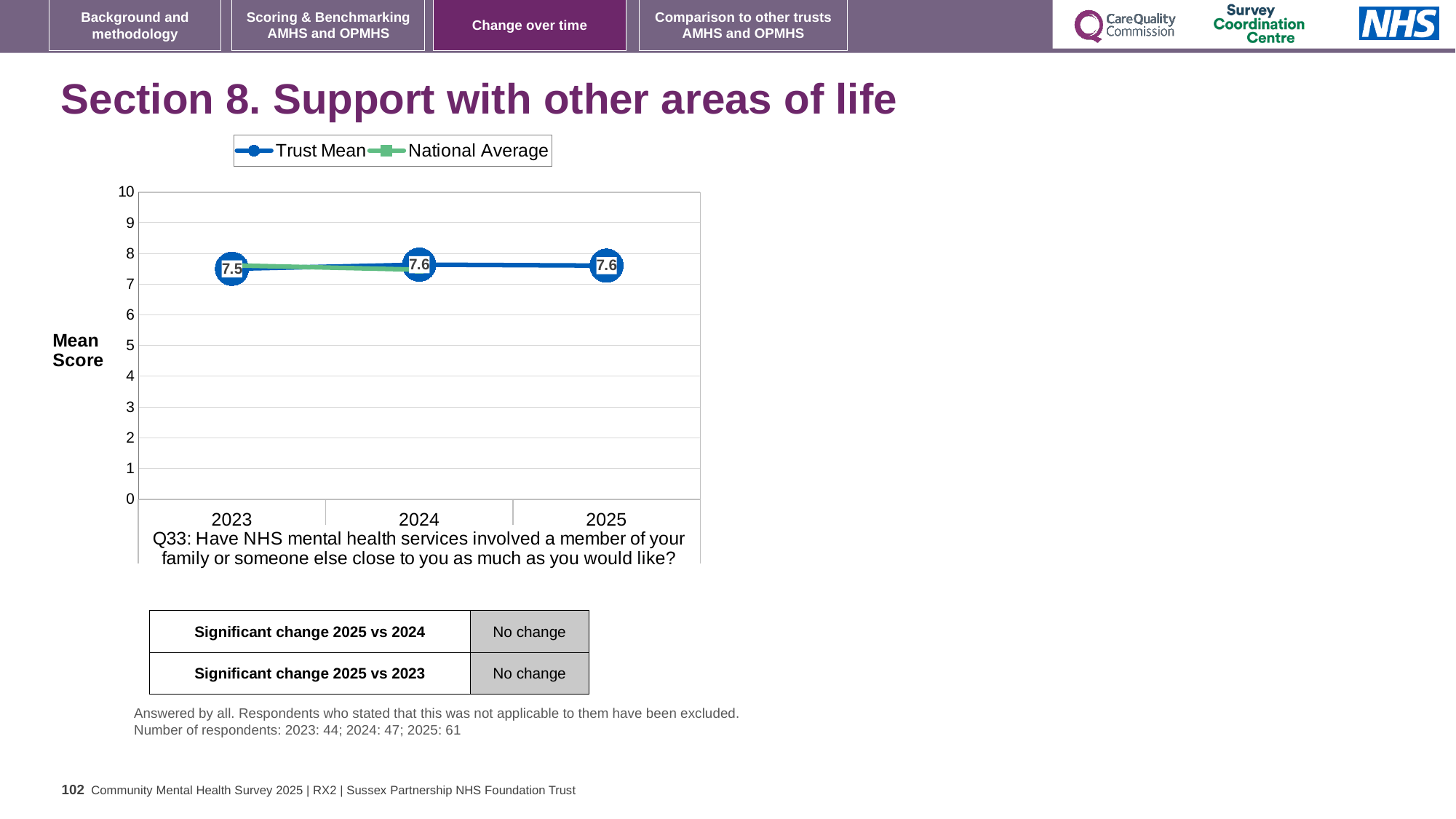
Which year has the lowest Trust Mean value? 2023 Which is larger, the Trust Mean for 2023 or for 2024? 2024 What is the difference between the Trust Mean values for 2024 and 2023? 0.1 How many series does the chart legend list? 2 How many years are shown on the x axis of the chart? 3 What kind of chart is shown on the slide? Line chart What is the Trust Mean value for 2023? 7.5 What is the Trust Mean value for 2025? 7.6 What is the label on the y axis of the chart? Mean Score What is the Trust Mean value for 2024? 7.6 Is the Trust Mean value for 2023 greater or less than 8? less